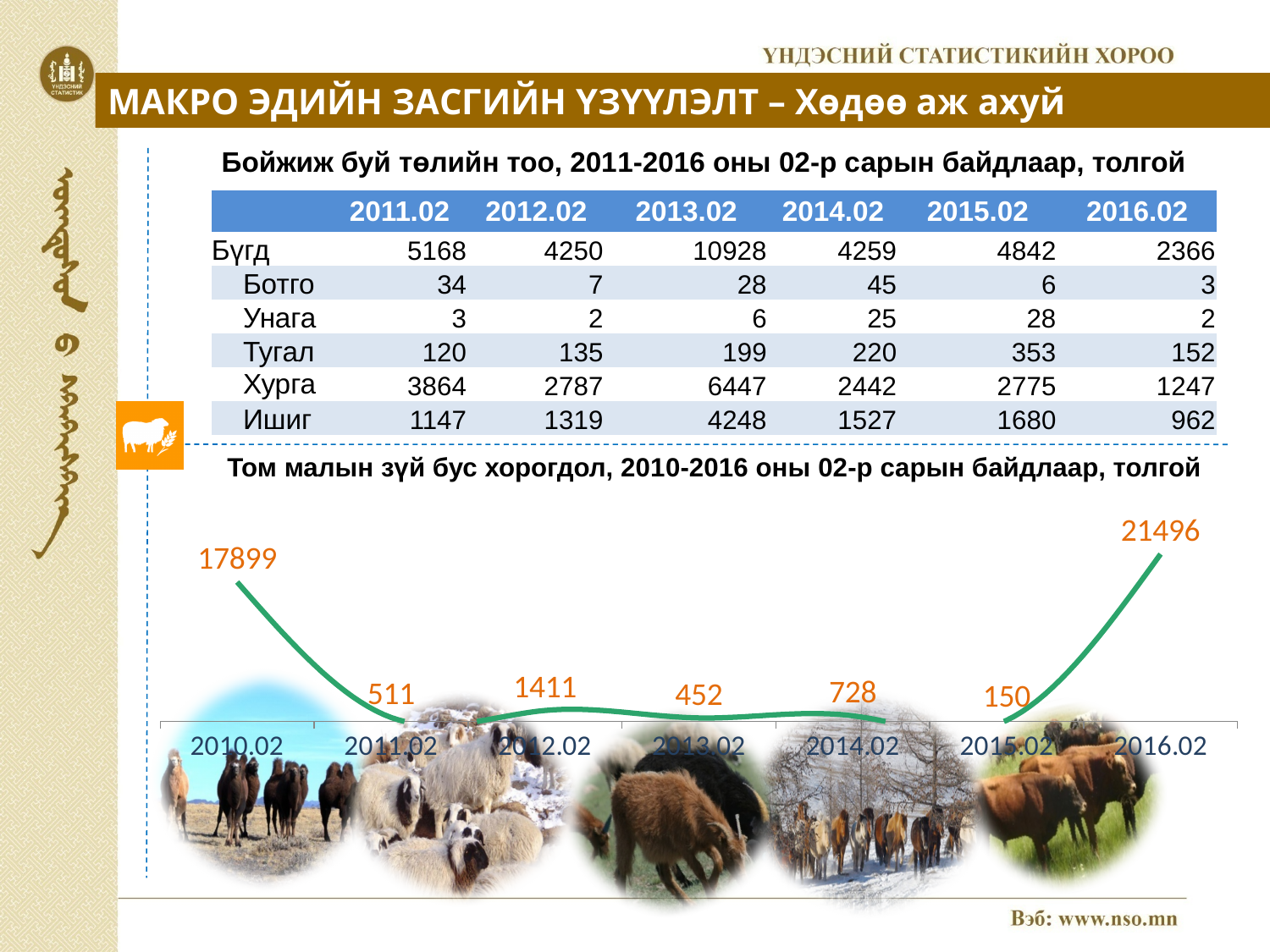
In the line chart, what is the difference between the values for 2016.02 and 2010.02? 3597 In the line chart, what is the difference between the values for 2012.02 and 2011.02? 900 In the line chart, what is the value for 2014.02? 728 What type of chart is shown at the bottom of the slide under the title "Том малын зүй бус хорогдол"? line chart In the line chart, what is the value for 2016.02? 21496 In the line chart, how many data points are plotted? 7 In the line chart, which period has the highest value? 2016.02 In the line chart, which is larger, the value for 2011.02 or the value for 2013.02? 2011.02 In the line chart, which period has the lowest value? 2015.02 In the line chart, does the value rise or fall from 2015.02 to 2016.02? rise In the line chart, what is the value for 2010.02? 17899 In the line chart, what is the value for 2012.02? 1411